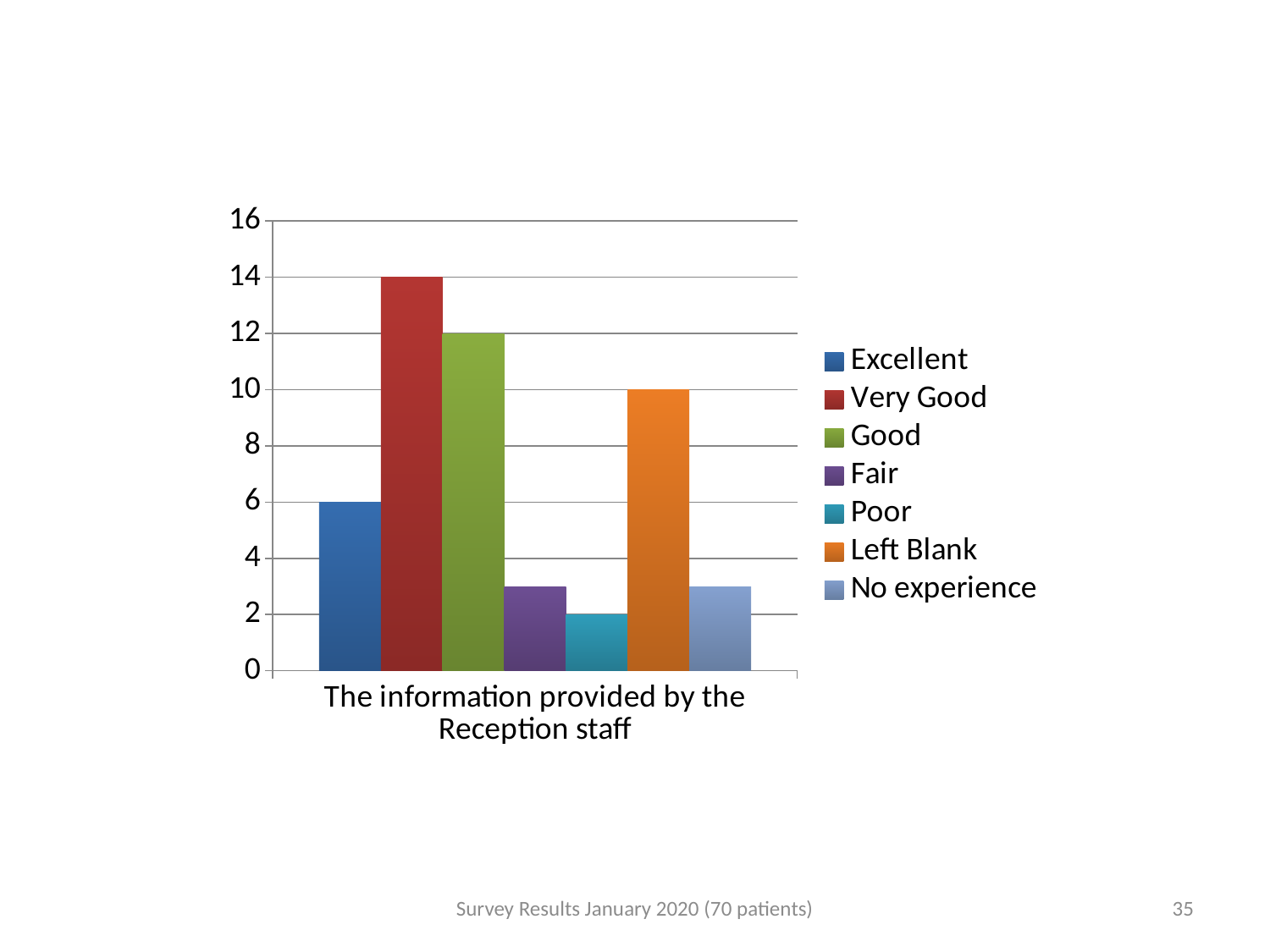
What is the value for Very Good? 14 What is the value for Poor? 2 Which response has the lowest value? Poor What type of chart is shown on the slide? bar chart What is the value for Good? 12 Is the value for Fair greater or less than 4? less Which response has the highest value? Very Good What is the value for Left Blank? 10 Which is larger, the value for Excellent or the value for Left Blank? Left Blank How many series does the legend list? 7 What is the value for Excellent? 6 What is the difference between the values for Very Good and Good? 2